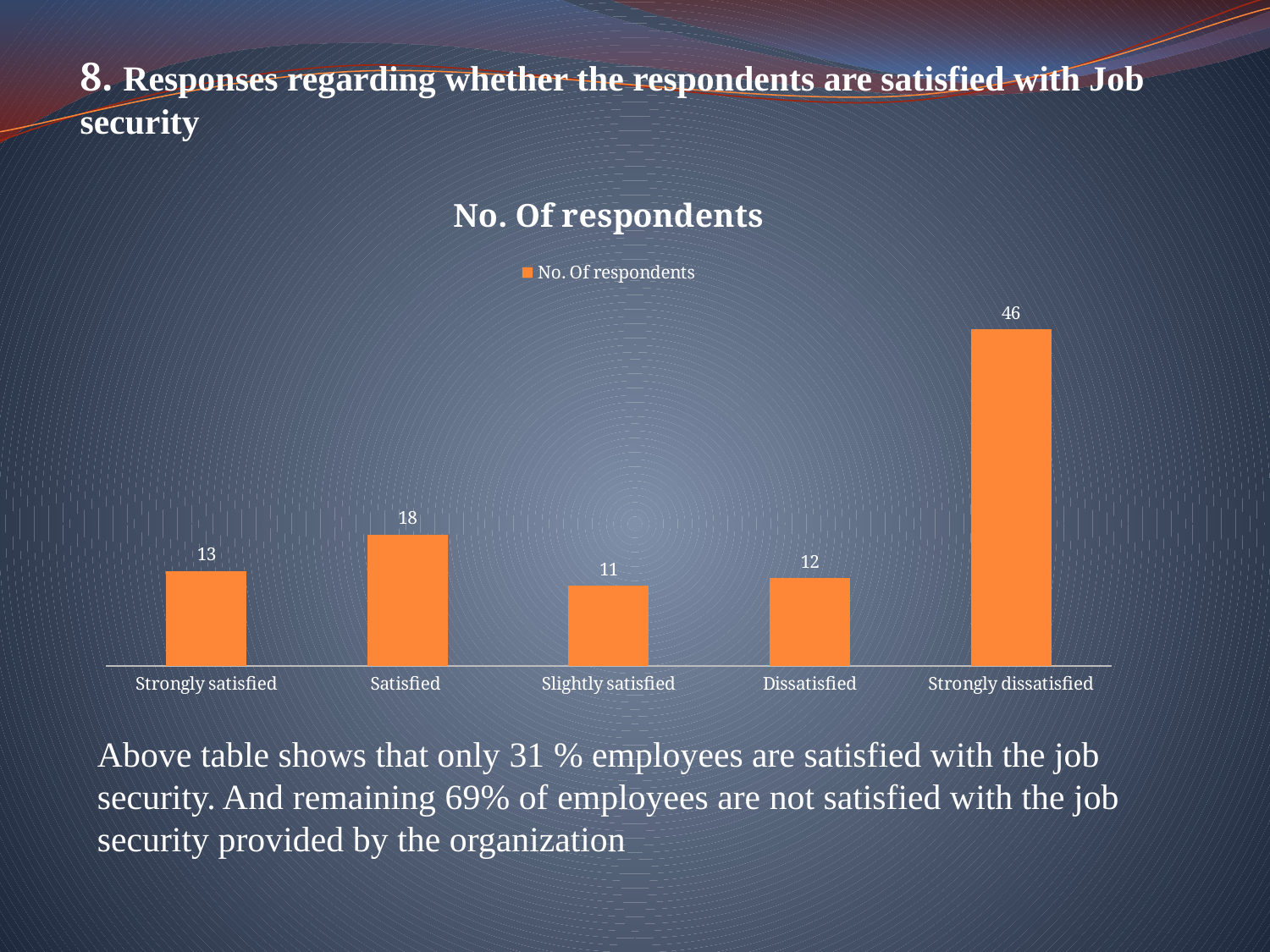
Which category has the highest number of respondents? Strongly dissatisfied What is the difference in respondents between Strongly satisfied and Dissatisfied? 1 What is the number of respondents for Strongly dissatisfied? 46 Which has more respondents, Satisfied or Strongly satisfied? Satisfied What is the number of respondents for Slightly satisfied? 11 How many series does the legend list? 1 What is the difference in respondents between Strongly dissatisfied and Satisfied? 28 Which category has the lowest number of respondents? Slightly satisfied What is the title of the chart? No. Of respondents What is the number of respondents for Satisfied? 18 How many categories are shown on the x axis? 5 What kind of chart is shown on the slide? Bar chart